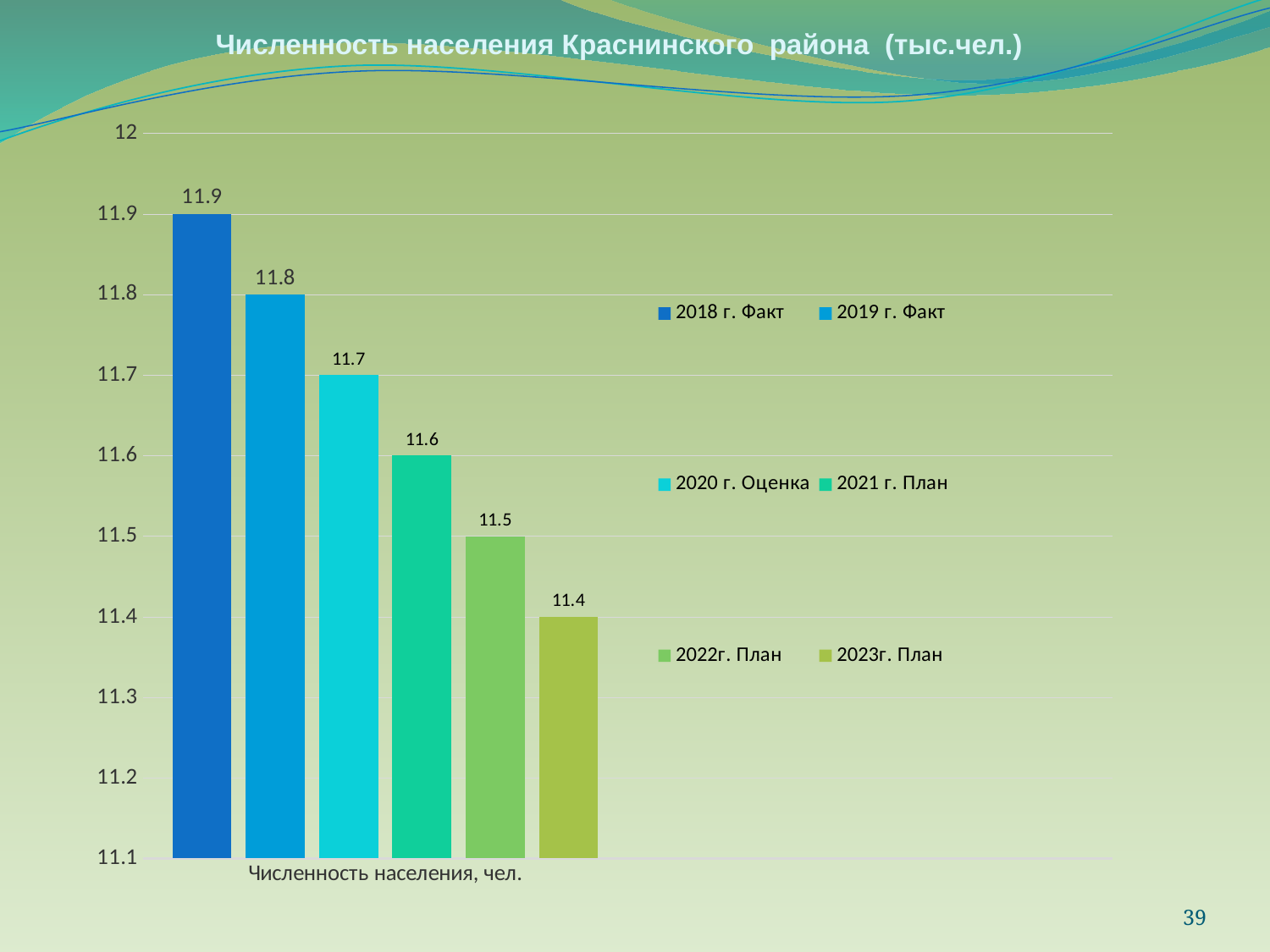
What is the value for 2020 г. Оценка? 11.7 What kind of chart is shown on the slide? bar chart How many bars are plotted on the chart? 6 Which series has the lowest value? 2023г. План Which is larger, the value for 2019 г. Факт or the value for 2021 г. План? 2019 г. Факт Is the value for 2022г. План greater or less than 11.6? less How many series does the legend list? 6 What is the value for 2018 г. Факт? 11.9 What is the difference between the values for 2018 г. Факт and 2023г. План? 0.5 What is the value for 2023г. План? 11.4 Do the values rise or fall from 2018 г. Факт to 2023г. План? fall Which series has the highest value? 2018 г. Факт